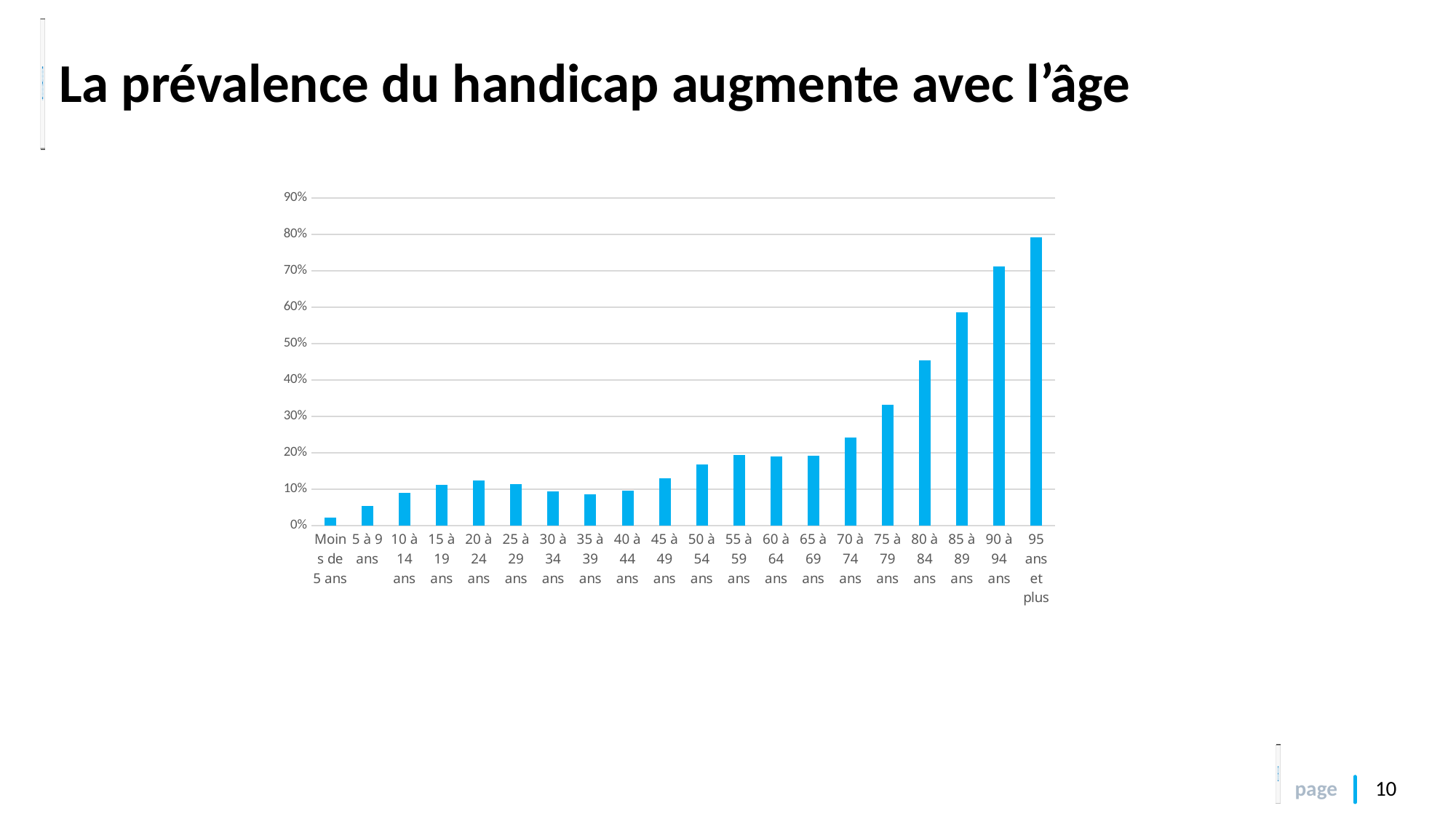
Which is larger, the value for 80 à 84 ans or the value for 75 à 79 ans? 80 à 84 ans How many age categories are shown on the x axis of the chart? 20 Is the value for 85 à 89 ans greater or less than 50%? greater Do the values generally rise or fall as age increases along the x axis? Rise Which age category has the lowest value in the chart? Moins de 5 ans Is the value for 95 ans et plus greater or less than 70%? greater What kind of chart is shown on the slide? Bar chart Is the value for 80 à 84 ans greater or less than 50%? less Which age category has the highest value in the chart? 95 ans et plus What is the title of the slide containing the chart? La prévalence du handicap augmente avec l’âge